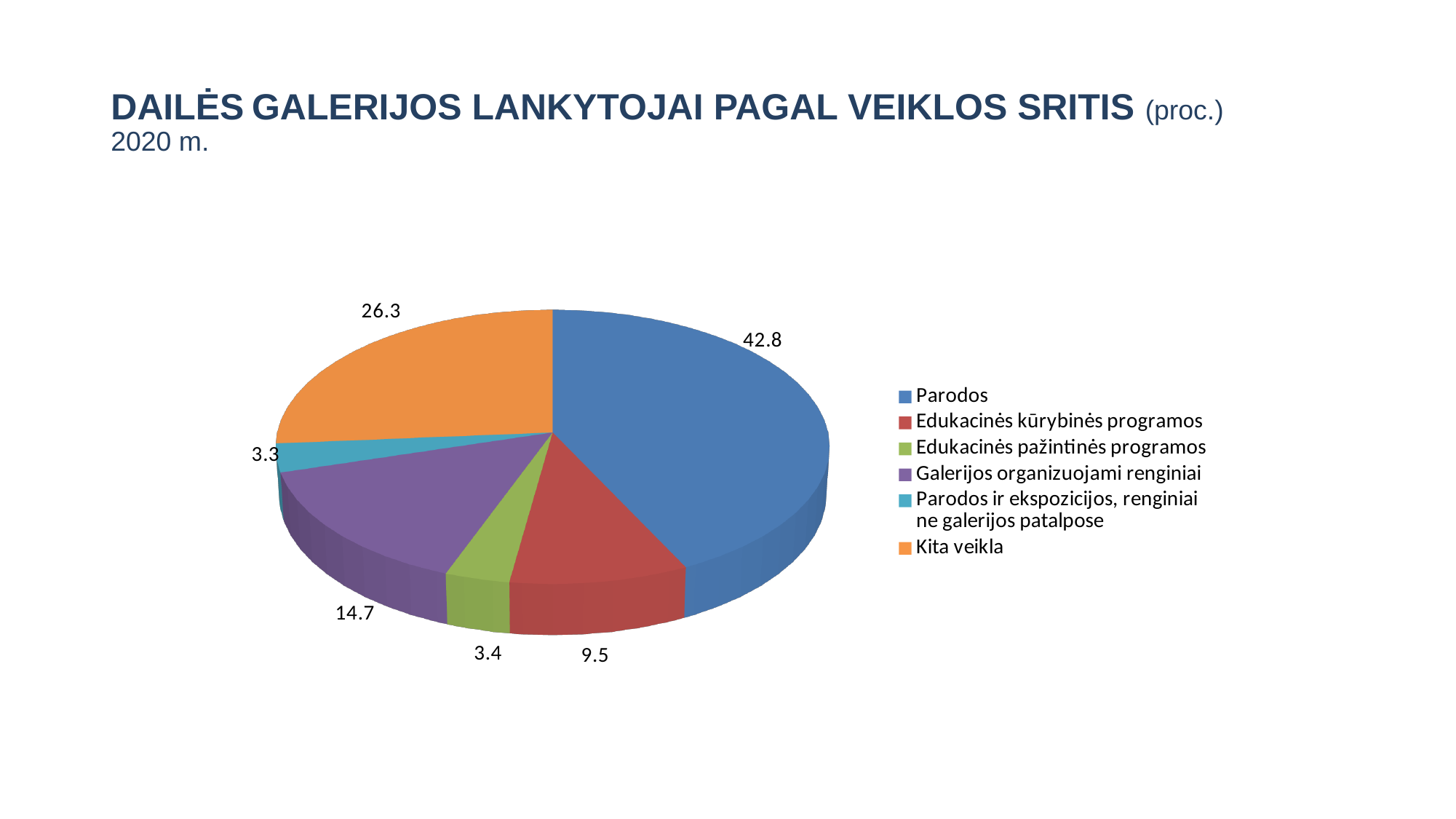
Which category has the largest slice of the pie? Parodos What is the value for Parodos ir ekspozicijos, renginiai ne galerijos patalpose? 3.3 What year does the chart title refer to? 2020 m. What is the difference between the values for Parodos and Kita veikla? 16.5 How many categories does the pie chart have? 6 What is the value for Edukacinės kūrybinės programos? 9.5 What is the value for Galerijos organizuojami renginiai? 14.7 Which category has the smallest slice of the pie? Parodos ir ekspozicijos, renginiai ne galerijos patalpose What kind of chart is shown on the slide? pie chart Which is larger, the value for Galerijos organizuojami renginiai or the value for Edukacinės kūrybinės programos? Galerijos organizuojami renginiai What is the value for Kita veikla? 26.3 What is the value for Parodos? 42.8